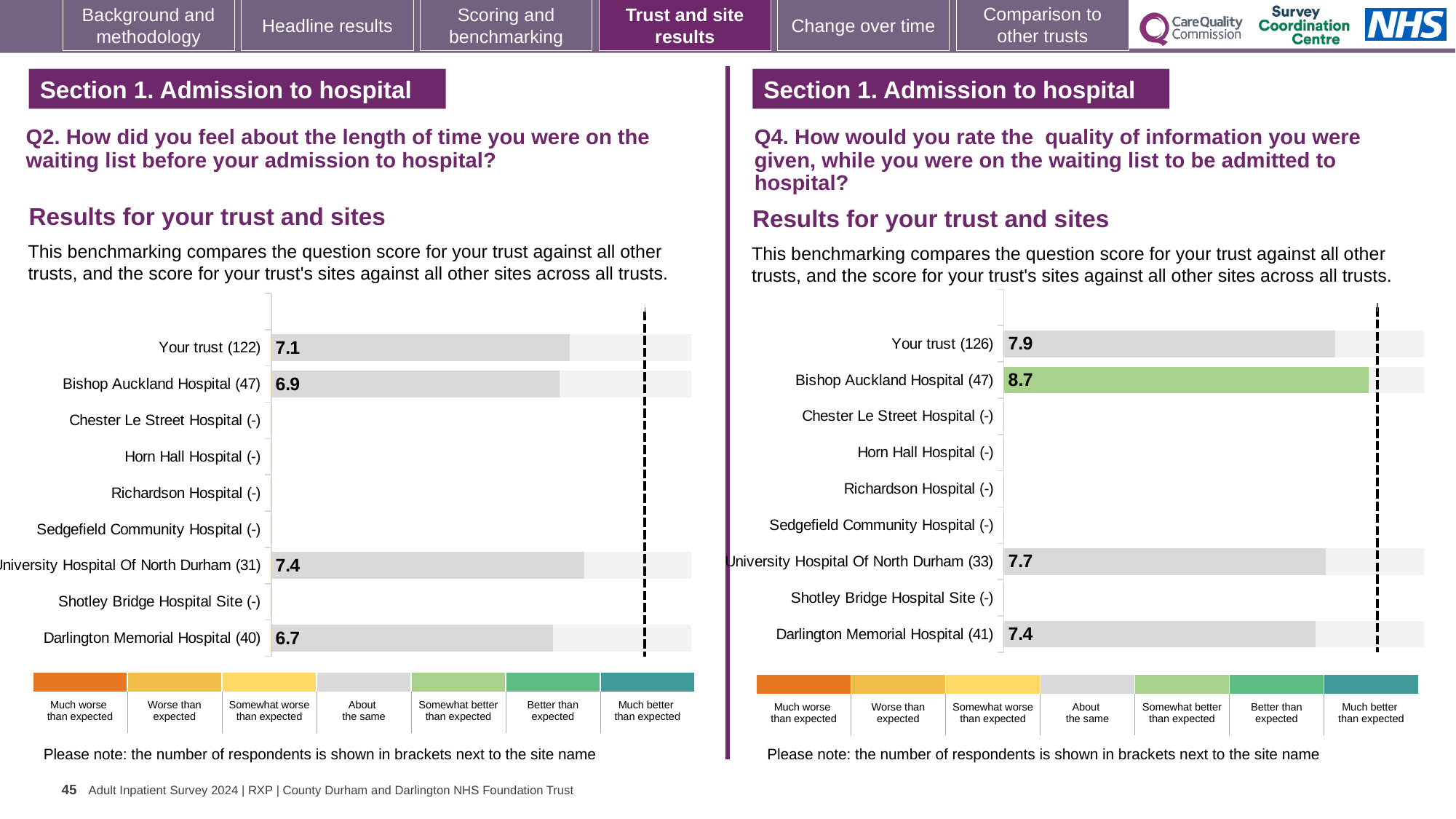
On the Q4 chart (right), what is the score for University Hospital Of North Durham? 7.7 On the Q2 chart (left), what is the score for Your trust? 7.1 On the Q4 chart (right), which site or trust row has the highest score? Bishop Auckland Hospital On the Q2 chart (left), which site or trust row has the highest score? University Hospital Of North Durham How many site or trust rows are listed on the Q2 chart (left)? 9 On the Q4 chart (right), what is the score for Bishop Auckland Hospital? 8.7 On the Q2 chart (left), which site or trust row has the lowest score? Darlington Memorial Hospital On the Q2 chart (left), what is the difference between the score for University Hospital Of North Durham and the score for Bishop Auckland Hospital? 0.5 On the Q4 chart (right), what is the difference between the score for Bishop Auckland Hospital and the score for Your trust? 0.8 What kind of chart is the Q4 chart (right)? Bar chart On the Q4 chart (right), which is larger: the score for Your trust or the score for Darlington Memorial Hospital? Your trust On the Q2 chart (left), what is the score for Darlington Memorial Hospital? 6.7